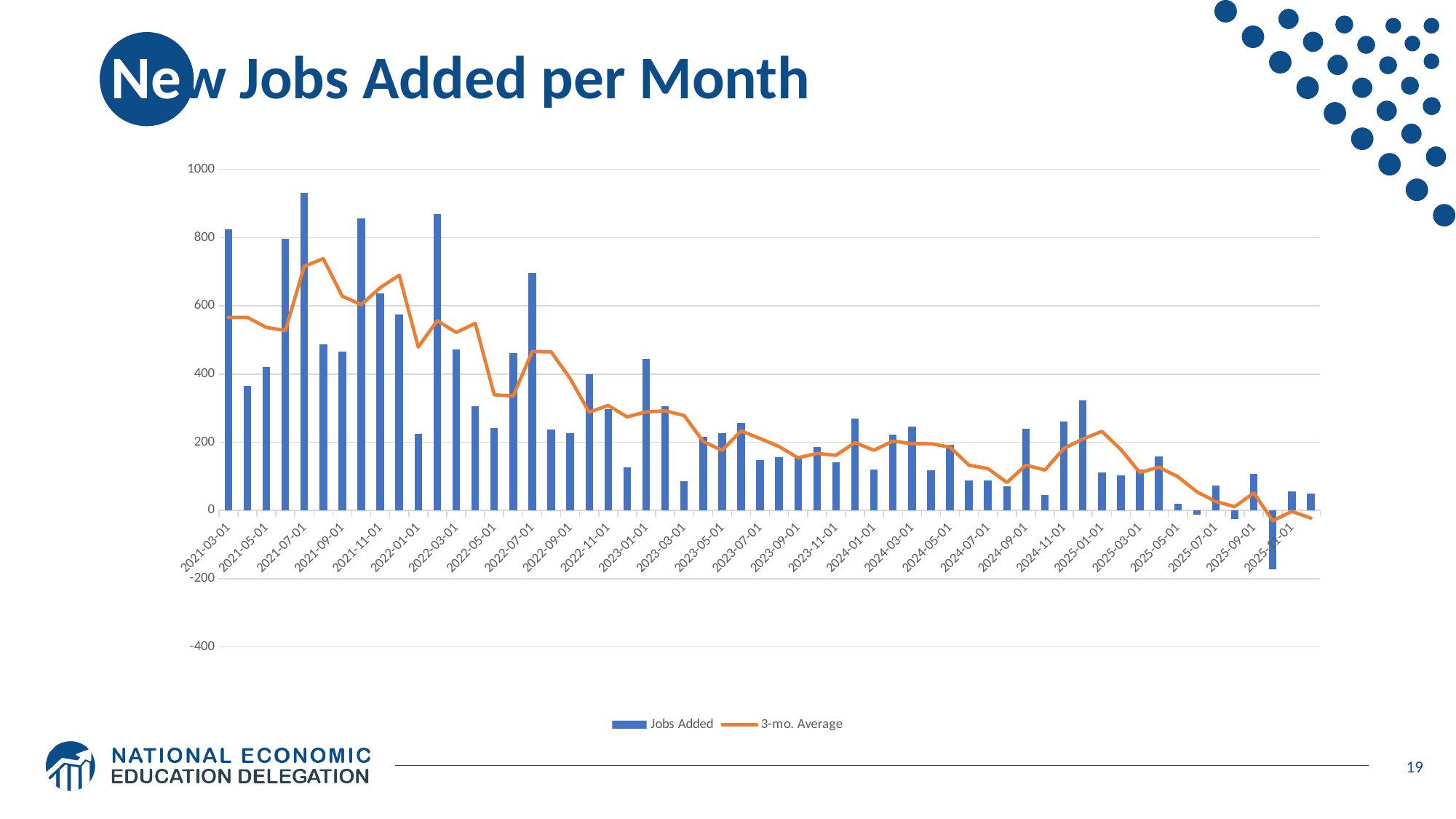
What kind of chart is used for the Jobs Added series? bar chart Is the Jobs Added value for 2025-09-01 greater or less than 0? greater How many series does the legend list? 2 What is the title of the chart? New Jobs Added per Month Which has the larger Jobs Added value, 2021-07-01 or 2025-11-01? 2021-07-01 Is the Jobs Added value for 2021-07-01 greater or less than 800? greater Is the Jobs Added value for 2023-03-01 greater or less than 200? less What are the two series named in the legend? Jobs Added and 3-mo. Average Overall, do the Jobs Added values rise or fall from 2021 to 2025? fall Which labeled month has the highest Jobs Added bar? 2021-07-01